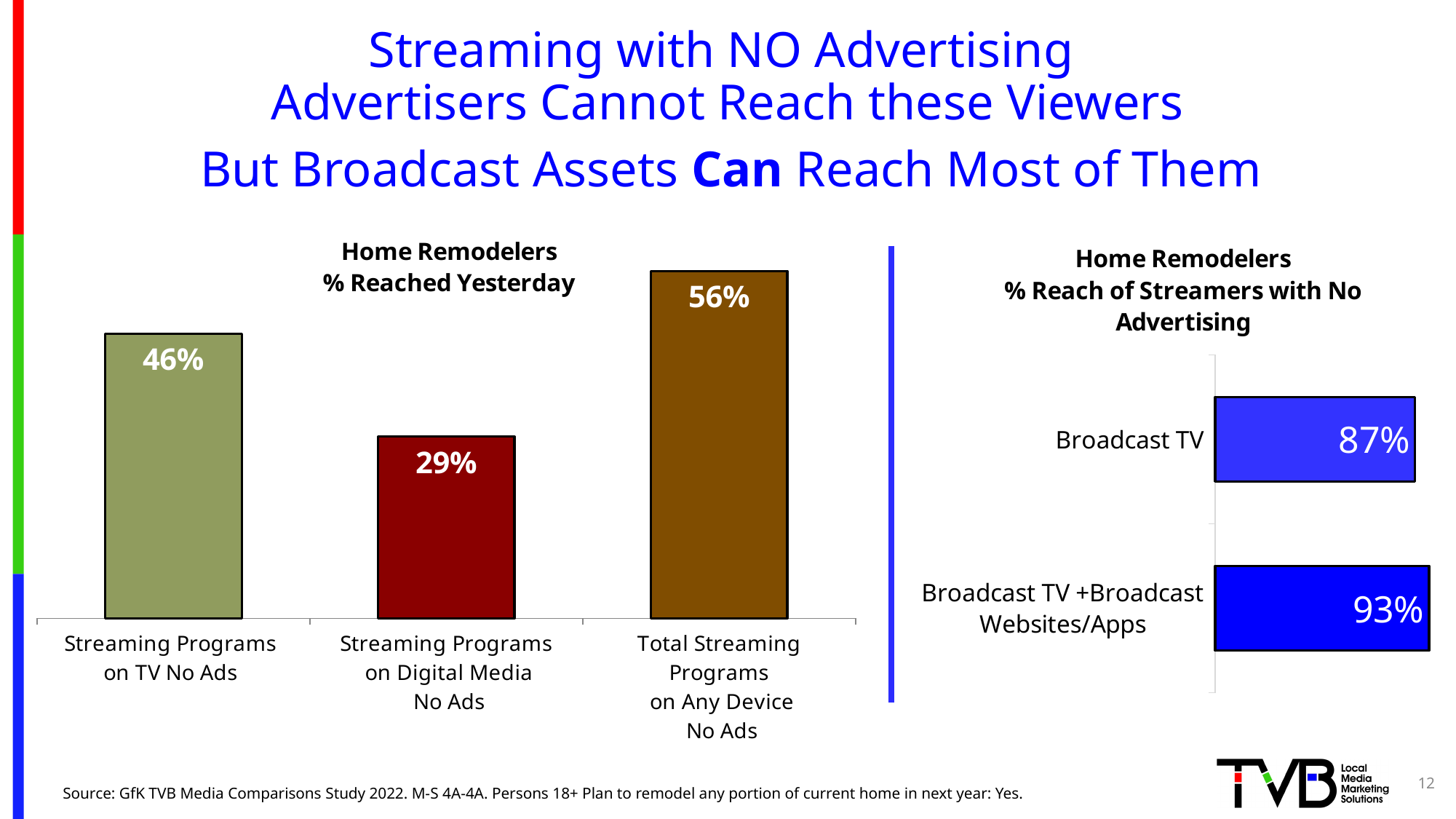
In the left chart (Home Remodelers % Reached Yesterday), what is the value for Streaming Programs on Digital Media No Ads? 29% In the left chart (Home Remodelers % Reached Yesterday), which category has the lowest value? Streaming Programs on Digital Media No Ads In the right chart (Home Remodelers % Reach of Streamers with No Advertising), what is the value for Broadcast TV? 87% In the left chart (Home Remodelers % Reached Yesterday), how many categories are shown? 3 What kind of chart is the right chart (Home Remodelers % Reach of Streamers with No Advertising)? Bar chart In the left chart (Home Remodelers % Reached Yesterday), what is the value for Streaming Programs on TV No Ads? 46% In the left chart (Home Remodelers % Reached Yesterday), which category has the highest value? Total Streaming Programs on Any Device No Ads What is the title of the left chart? Home Remodelers % Reached Yesterday In the right chart (Home Remodelers % Reach of Streamers with No Advertising), what is the difference between Broadcast TV + Broadcast Websites/Apps and Broadcast TV? 6% In the left chart (Home Remodelers % Reached Yesterday), what is the difference between Total Streaming Programs on Any Device No Ads and Streaming Programs on TV No Ads? 10% In the right chart (Home Remodelers % Reach of Streamers with No Advertising), which is larger: Broadcast TV or Broadcast TV + Broadcast Websites/Apps? Broadcast TV + Broadcast Websites/Apps In the right chart (Home Remodelers % Reach of Streamers with No Advertising), what is the value for Broadcast TV + Broadcast Websites/Apps? 93%